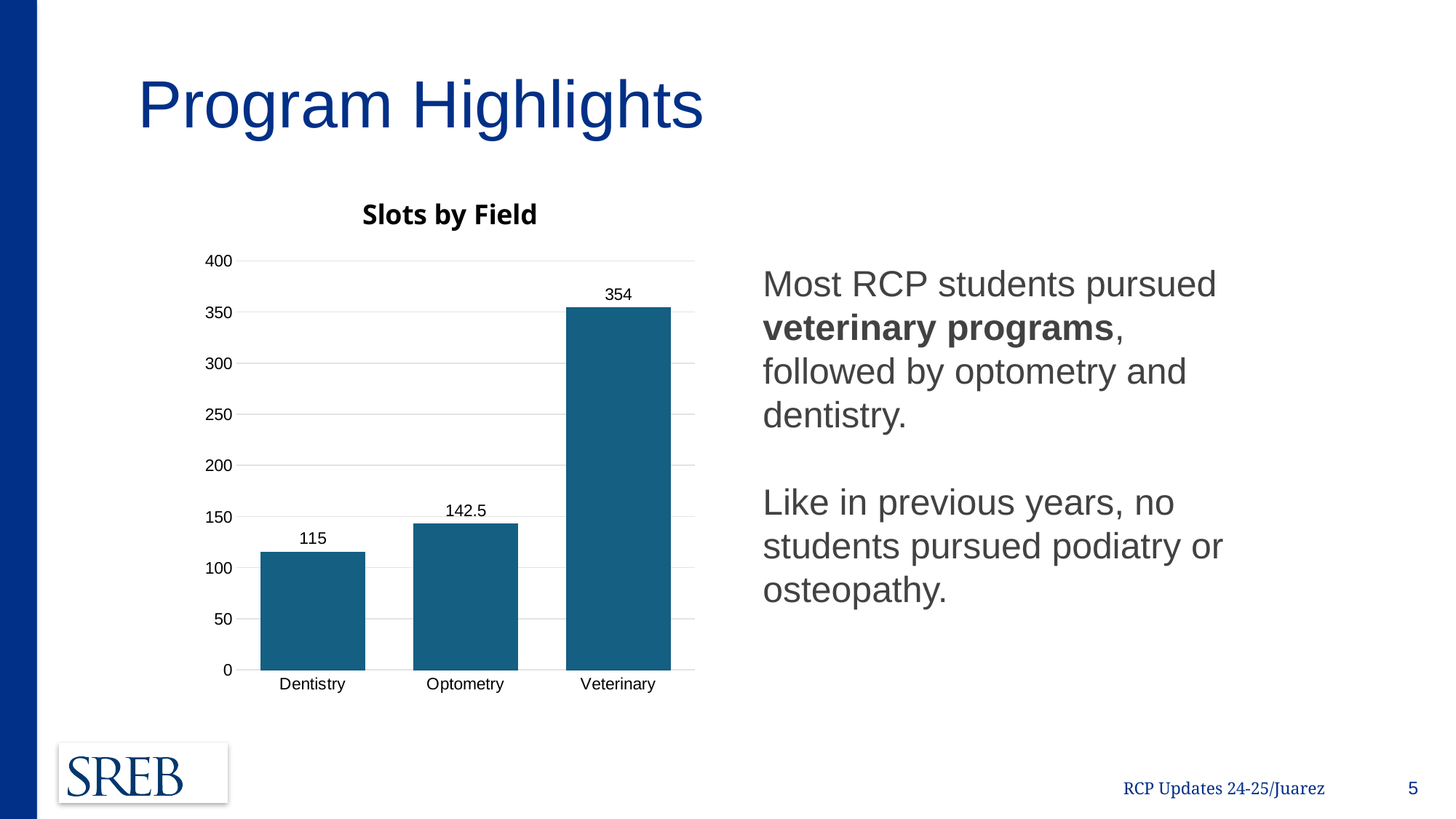
Which field has the highest number of slots? Veterinary What is the difference between the Veterinary and Dentistry values? 239 Which field has the lowest number of slots? Dentistry How many fields are shown in the Slots by Field chart? 3 Is the value for Veterinary greater or less than 300? greater What is the title of the chart on the slide? Slots by Field What is the value for Veterinary in the Slots by Field chart? 354 What kind of chart is shown on the slide? Bar chart What is the value for Dentistry in the Slots by Field chart? 115 Which is larger, the value for Optometry or the value for Dentistry? Optometry What is the value for Optometry in the Slots by Field chart? 142.5 What is the difference between the Optometry and Dentistry values? 27.5